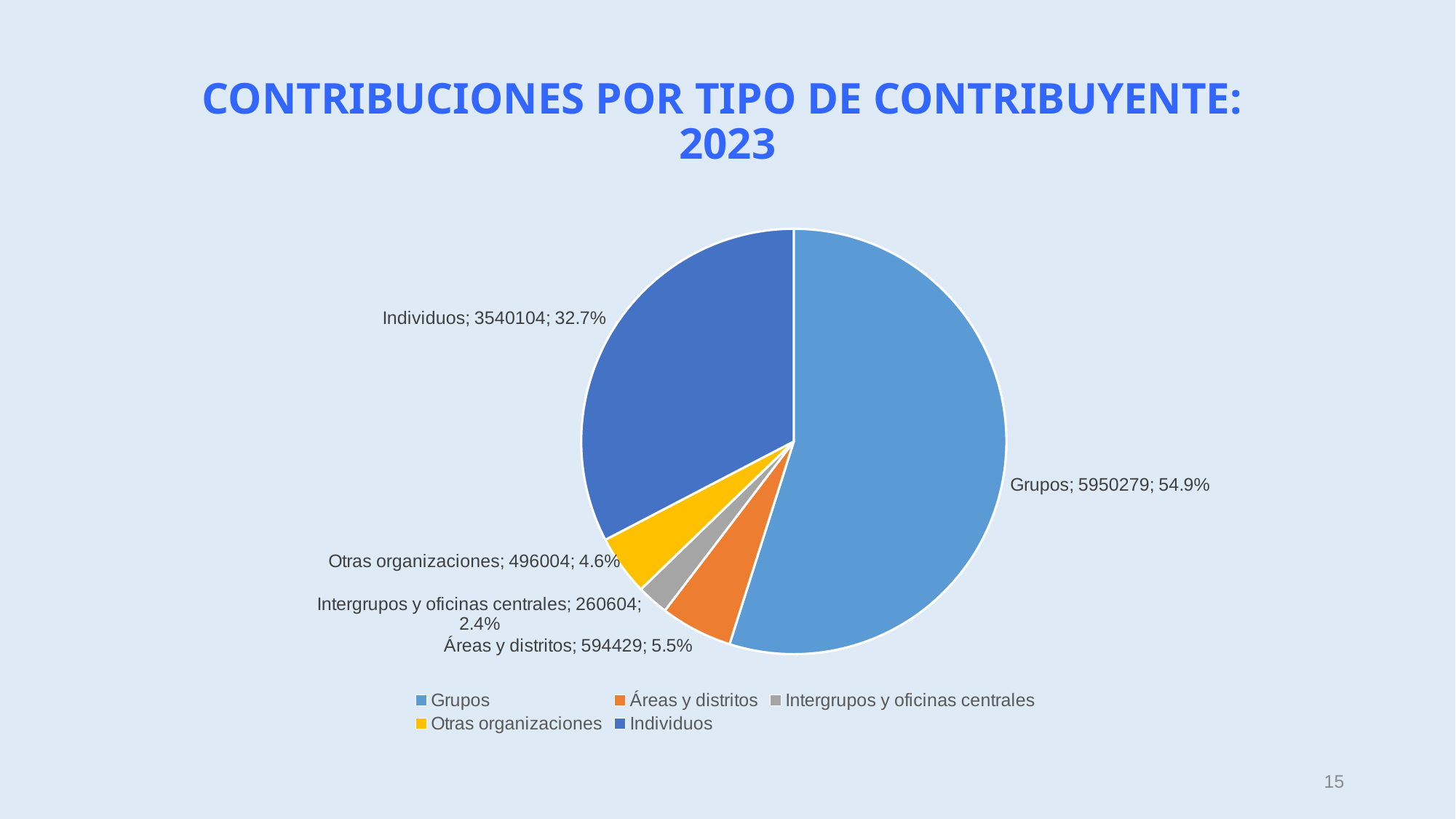
What is the value for Individuos? 3540104 What is the difference between the values for Grupos and Individuos? 2410175 What share of the pie does Grupos represent? 54.9% What is the value for Áreas y distritos? 594429 What type of chart is shown on the slide? pie chart Which category has the largest slice? Grupos What share of the pie does Otras organizaciones represent? 4.6% Which category has the smallest slice? Intergrupos y oficinas centrales What is the value for Intergrupos y oficinas centrales? 260604 Which is larger, Áreas y distritos or Otras organizaciones? Áreas y distritos What is the value for Grupos? 5950279 How many categories does the pie chart have? 5